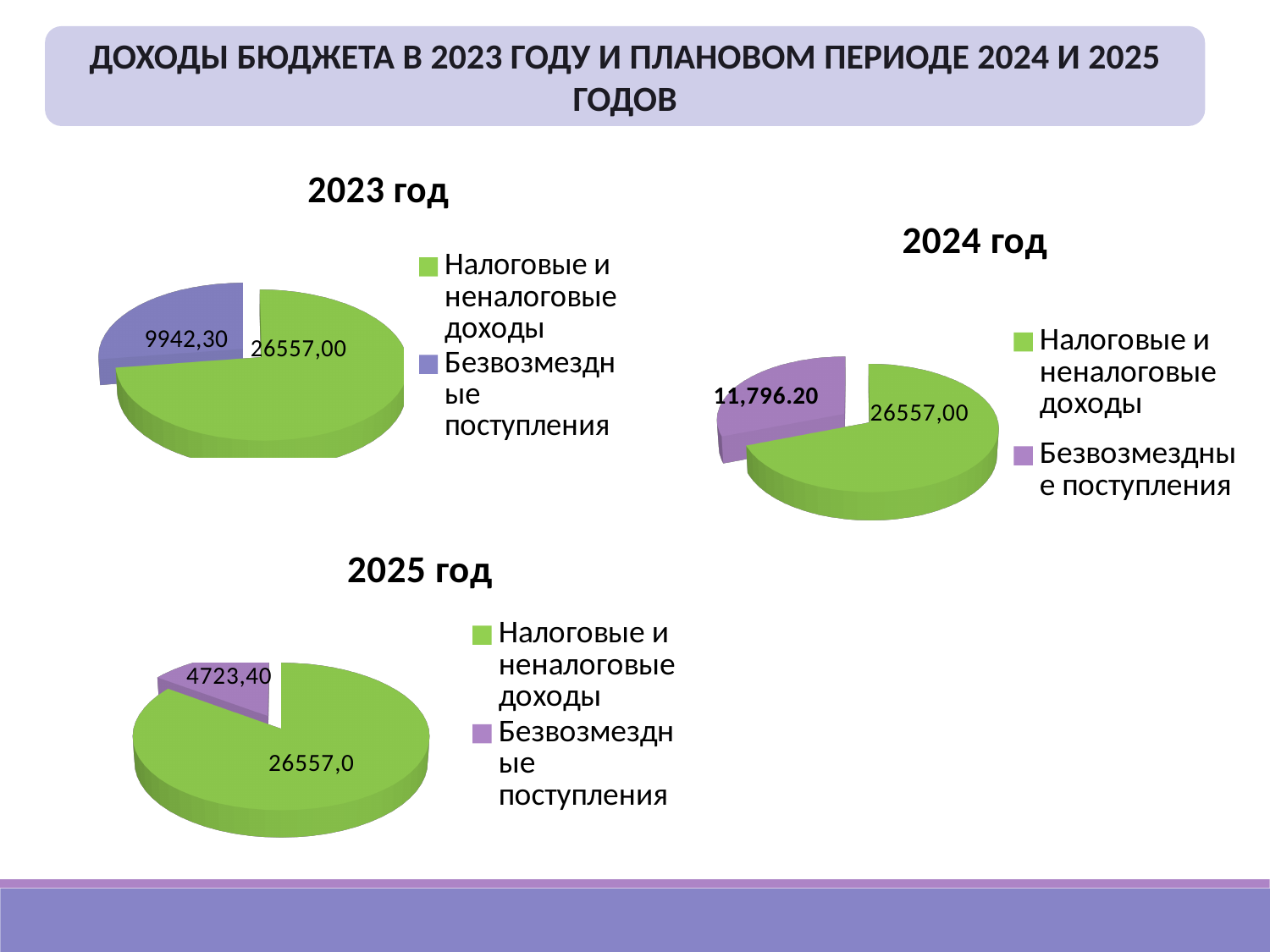
How many pie charts are shown on the slide? 3 What kind of chart is the "2023 год" chart? pie chart In the "2023 год" chart, what is the difference between Налоговые и неналоговые доходы and Безвозмездные поступления? 16614,70 In the "2025 год" chart, what is the value for Безвозмездные поступления? 4723,40 How many slices does the "2024 год" pie chart have? 2 In the "2023 год" chart, what is the value for Налоговые и неналоговые доходы? 26557,00 In the "2024 год" chart, which category has the largest slice? Налоговые и неналоговые доходы In the "2024 год" chart, what is the value for Безвозмездные поступления? 11,796.20 In the "2023 год" chart, what is the value for Безвозмездные поступления? 9942,30 In the "2025 год" chart, which category has the smallest slice? Безвозмездные поступления In the "2025 год" chart, what is the value for Налоговые и неналоговые доходы? 26557,0 In the "2025 год" chart, what is the difference between Налоговые и неналоговые доходы and Безвозмездные поступления? 21833,6